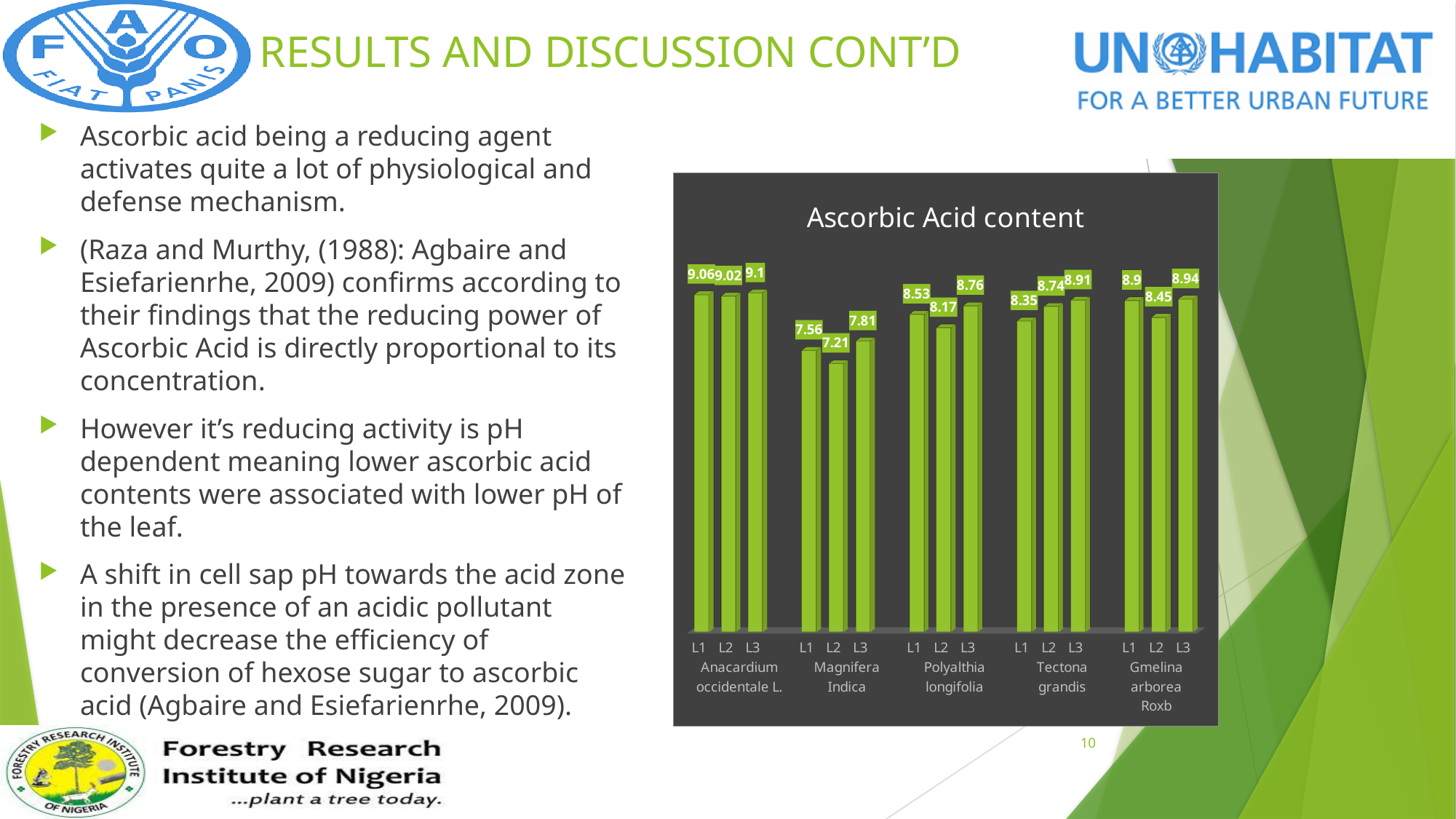
Which bar has the highest ascorbic acid content in the chart? L3 of Anacardium occidentale L. What kind of chart is shown on the slide? bar chart Which is larger, the L1 value for Tectona grandis or the L1 value for Gmelina arborea Roxb? Gmelina arborea Roxb What is the title of the chart? Ascorbic Acid content What is the ascorbic acid content for L1 of Polyalthia longifolia? 8.53 What is the ascorbic acid content for L2 of Tectona grandis? 8.74 What is the difference between the L3 and L2 values for Polyalthia longifolia? 0.59 What is the ascorbic acid content for L2 of Gmelina arborea Roxb? 8.45 Which bar has the lowest ascorbic acid content in the chart? L2 of Magnifera Indica How many bars are plotted in the chart? 15 What is the ascorbic acid content for L3 of Anacardium occidentale L.? 9.1 What is the ascorbic acid content for L2 of Magnifera Indica? 7.21